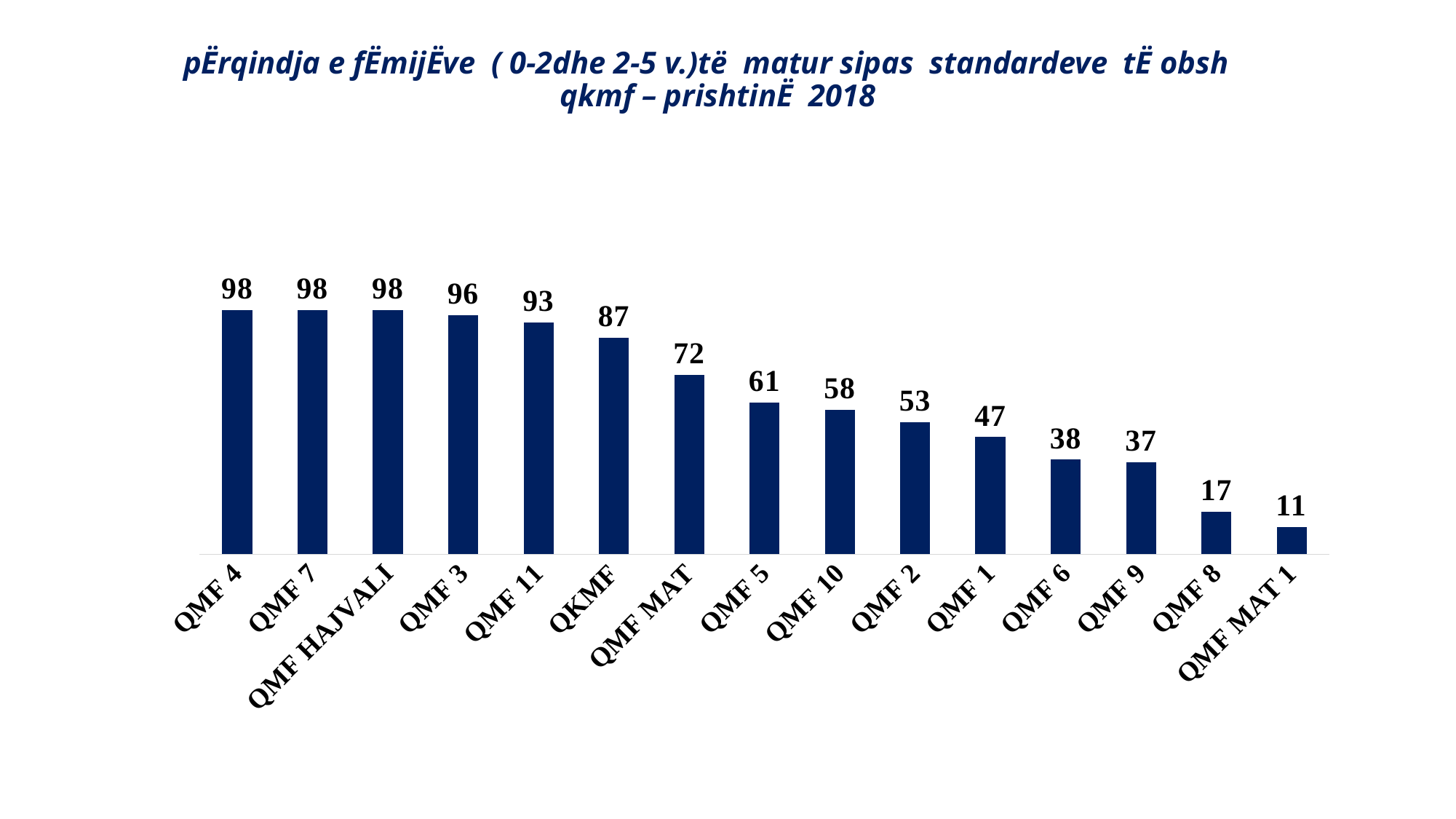
Do the values rise or fall from left to right along the x axis? Fall What is the difference between the values for QMF 8 and QMF MAT 1? 6 Which has a larger value, QMF 6 or QMF 2? QMF 2 Which category has the lowest value? QMF MAT 1 How many categories are shown on the chart? 15 What kind of chart is shown on the slide? Bar chart What is the value for QKMF? 87 What is the difference between the values for QMF 11 and QMF 5? 32 What is the value for QMF 3? 96 Which has a larger value, QMF 10 or QMF 1? QMF 10 What is the value for QMF 9? 37 What is the value for QMF MAT? 72